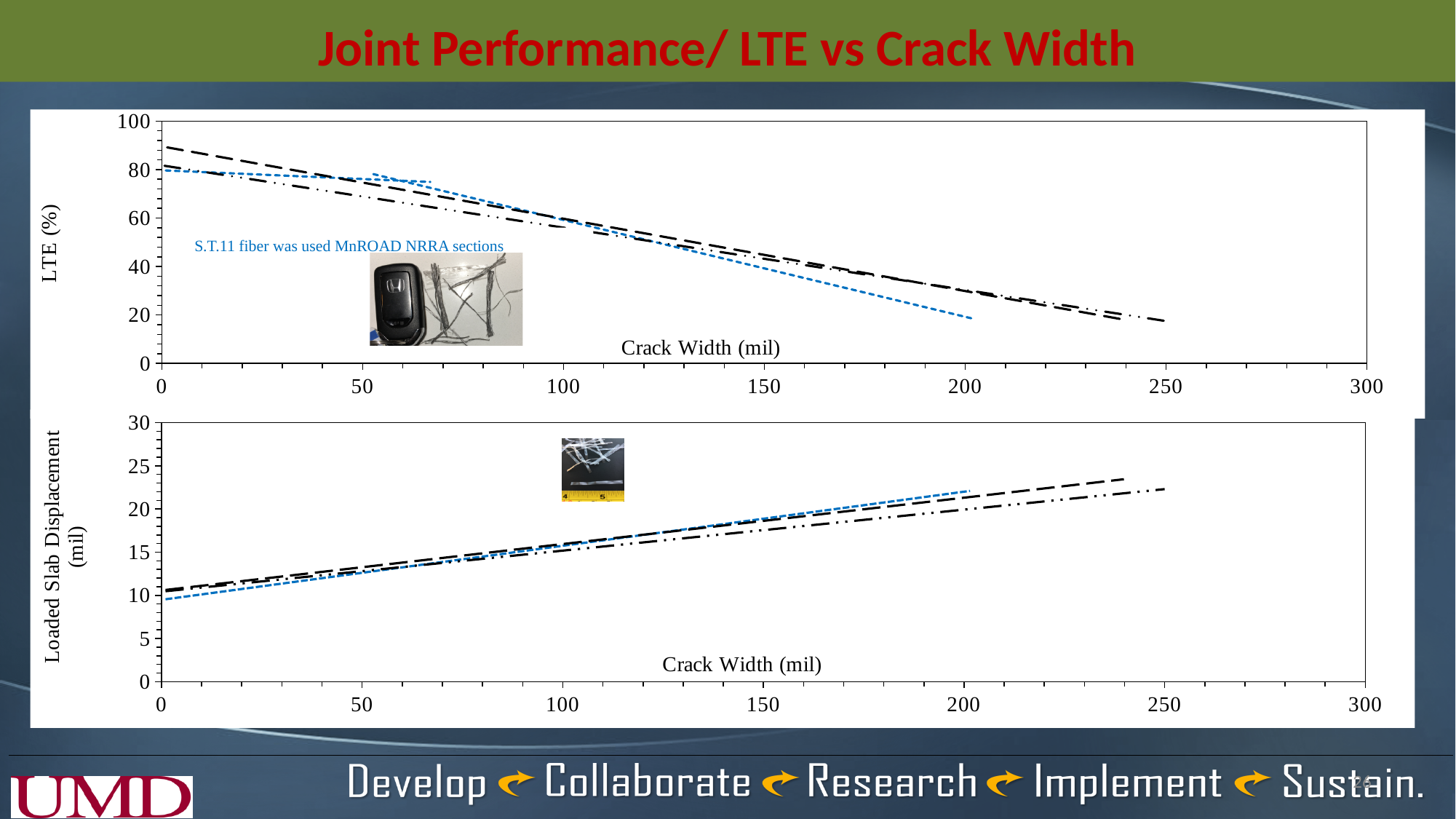
In the bottom chart (Loaded Slab Displacement vs Crack Width), do the plotted lines rise or fall as crack width increases? rise What is the x-axis label shared by both charts? Crack Width (mil) What is the y-axis label of the top chart? LTE (%) What kind of chart is the top chart on the slide? line chart How many lines are plotted in the top chart? 3 In the bottom chart, is the displacement value of the black dashed line at a crack width of 250 mil greater or less than 20? greater In the top chart, is the LTE value of the blue dotted line at a crack width of 50 mil greater or less than 60? greater What kind of chart is the bottom chart on the slide? line chart In the top chart, is the LTE value of the black dashed line at a crack width of 0 mil greater or less than 80? greater In the top chart (LTE vs Crack Width), do the plotted lines rise or fall as crack width increases? fall How many lines are plotted in the bottom chart? 3